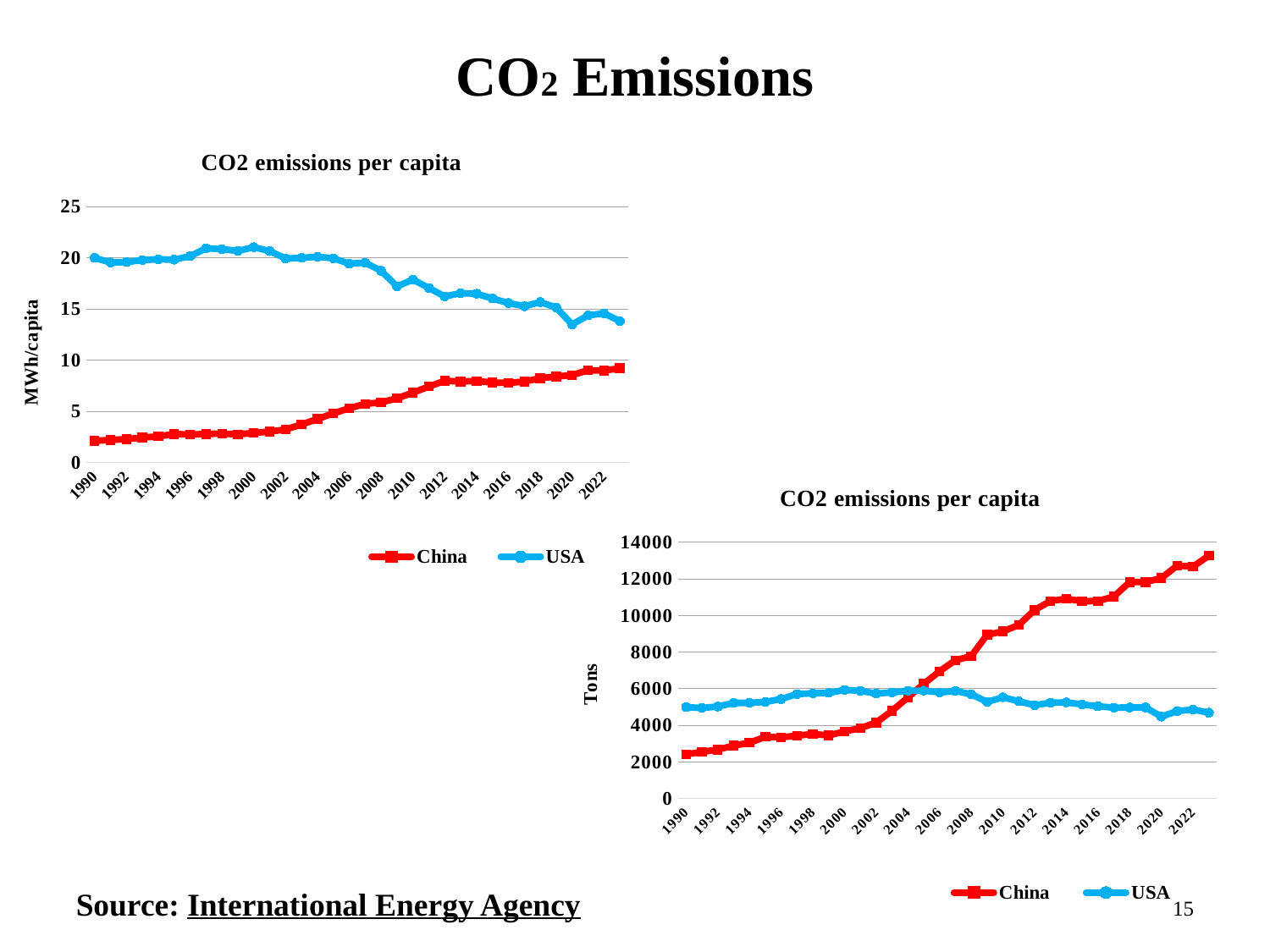
In the top-left chart, is the value for USA in 1990 greater or less than 15? greater In the top-left chart, which series has the larger value in 2022, China or USA? USA What kind of chart is the bottom-right chart with the y-axis labelled 'Tons'? line chart In the top-left chart, how many series does the legend list? 2 What kind of chart is the top-left chart titled 'CO2 emissions per capita'? line chart In the top-left chart, does the China line rise or fall from 1990 to 2022? rise In the top-left chart, does the USA line rise or fall from 1990 to 2022? fall In the bottom-right chart, is the value for USA in 2020 greater or less than 6000? less In the top-left chart, which two series are shown in the legend? China and USA In the top-left chart, is the value for China in 2022 greater or less than 5? greater In the bottom-right chart, which series has the larger value in 1990, China or USA? USA